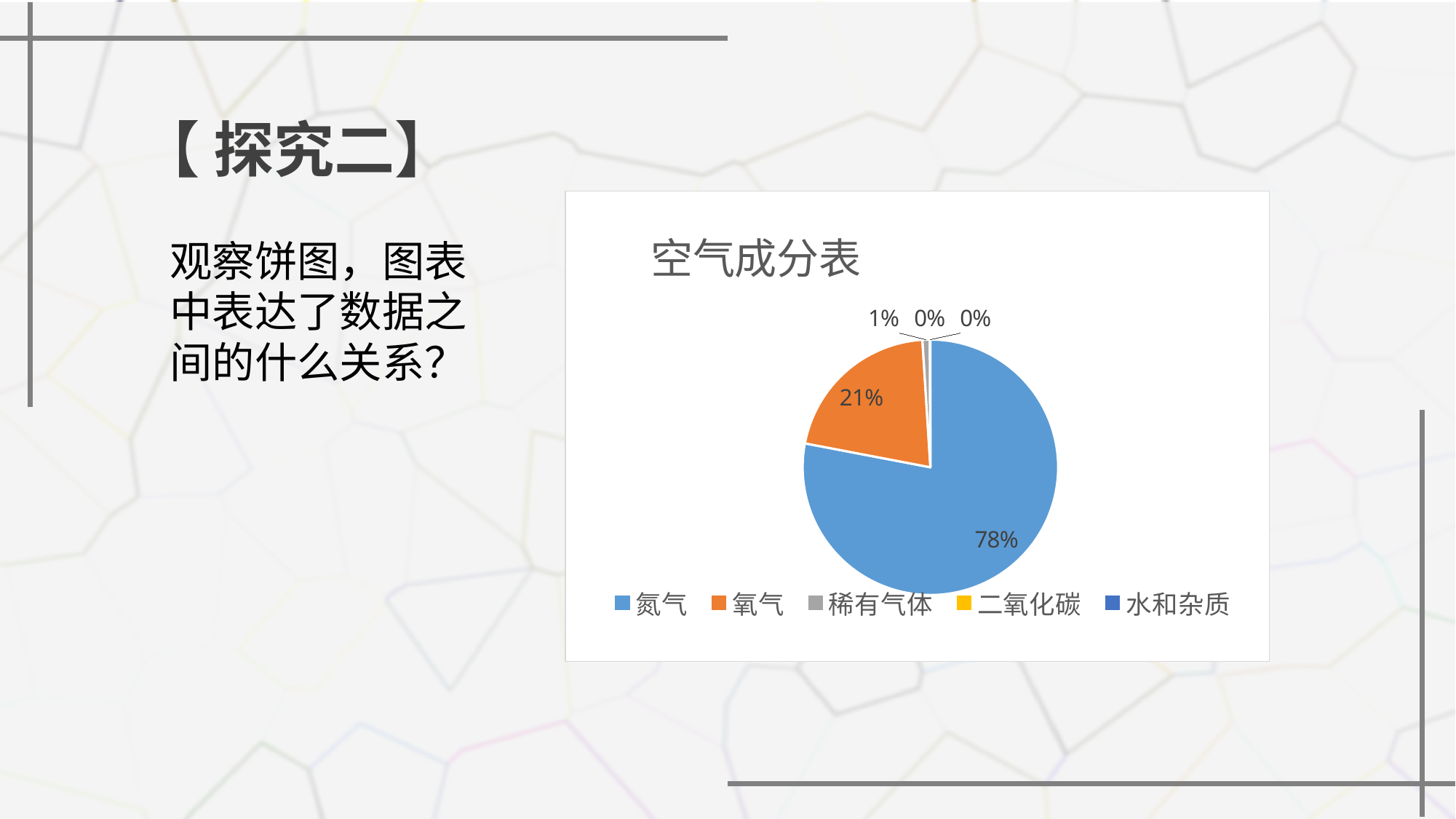
How many categories are listed in the legend? 5 What type of chart is shown on the slide? pie chart What is the value shown for 氧气? 21% What is the value shown for 二氧化碳? 0% What is the difference between the values for 氮气 and 氧气? 57% What percentage of the pie does 氮气 account for? 78% What colour is the slice for 氧气? orange Is the value for 氮气 greater or less than 50%? greater Which is larger, the slice for 氧气 or the slice for 稀有气体? 氧气 What is the value shown for 稀有气体? 1% Which category has the largest slice of the pie? 氮气 What is the title of the chart? 空气成分表